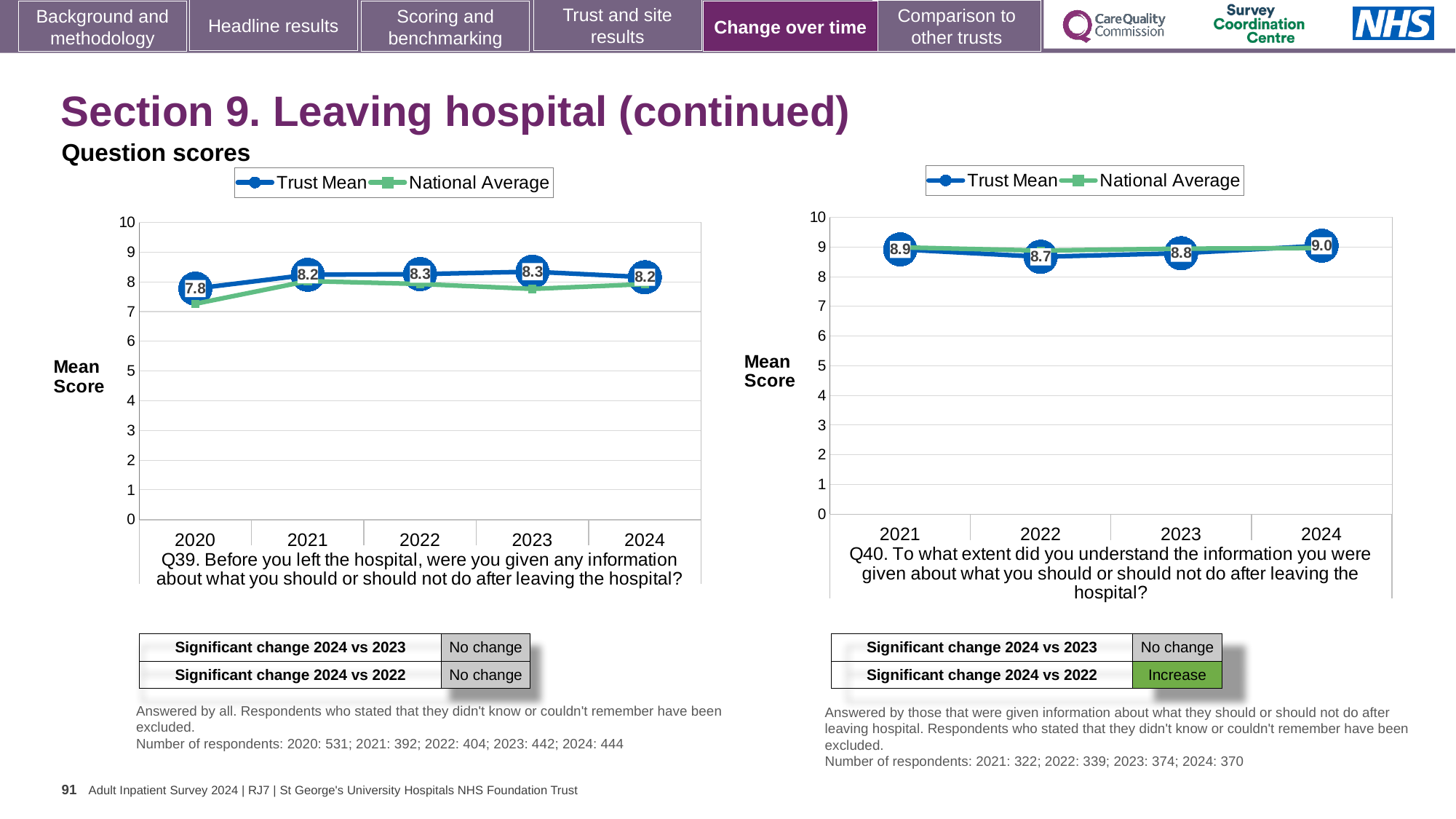
In the Q40 chart on the right, what is the Trust Mean score for 2022? 8.7 In the Q40 chart on the right, which year has the highest Trust Mean score? 2024 In the Q39 chart on the left, is the Trust Mean score for 2021 or 2020 larger? 2021 In the Q40 chart on the right, what is the Trust Mean score for 2024? 9.0 In the Q39 chart on the left, which year has the lowest Trust Mean score? 2020 In the Q40 chart on the right, what is the difference between the Trust Mean scores for 2024 and 2022? 0.3 In the Q39 chart on the left, what is the Trust Mean score for 2024? 8.2 How many years are plotted on the x axis of the Q40 chart on the right? 4 How many series does the legend of the Q39 chart on the left list? 2 In the Q39 chart on the left, what is the Trust Mean score for 2020? 7.8 In the Q39 chart on the left, is the National Average for 2020 greater or less than 8? less What type of chart is used for Q39 on the left? Line chart